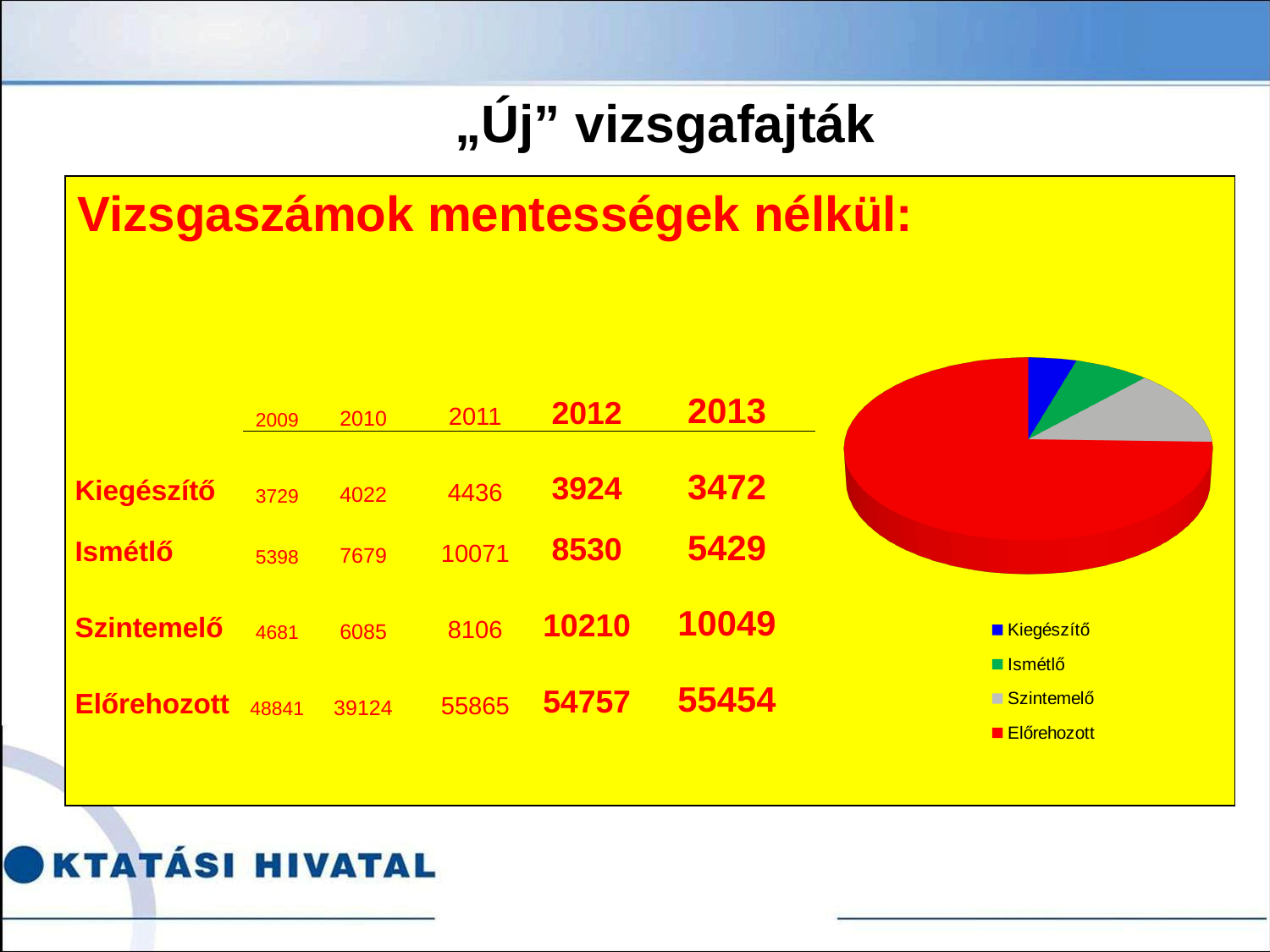
In the pie chart, which slice is larger: Szintemelő or Ismétlő? Szintemelő How many entries does the legend of the pie chart list? 4 Does the Előrehozott slice cover more or less than half of the pie chart? more What colour is the Előrehozott slice in the pie chart? red Which category has the smallest slice in the pie chart? Kiegészítő Which category is shown in blue in the pie chart legend? Kiegészítő What kind of chart is shown on the right side of the slide? pie chart How many slices does the pie chart have? 4 Which category has the largest slice in the pie chart? Előrehozott In the pie chart, which slice is larger: Előrehozott or Szintemelő? Előrehozott